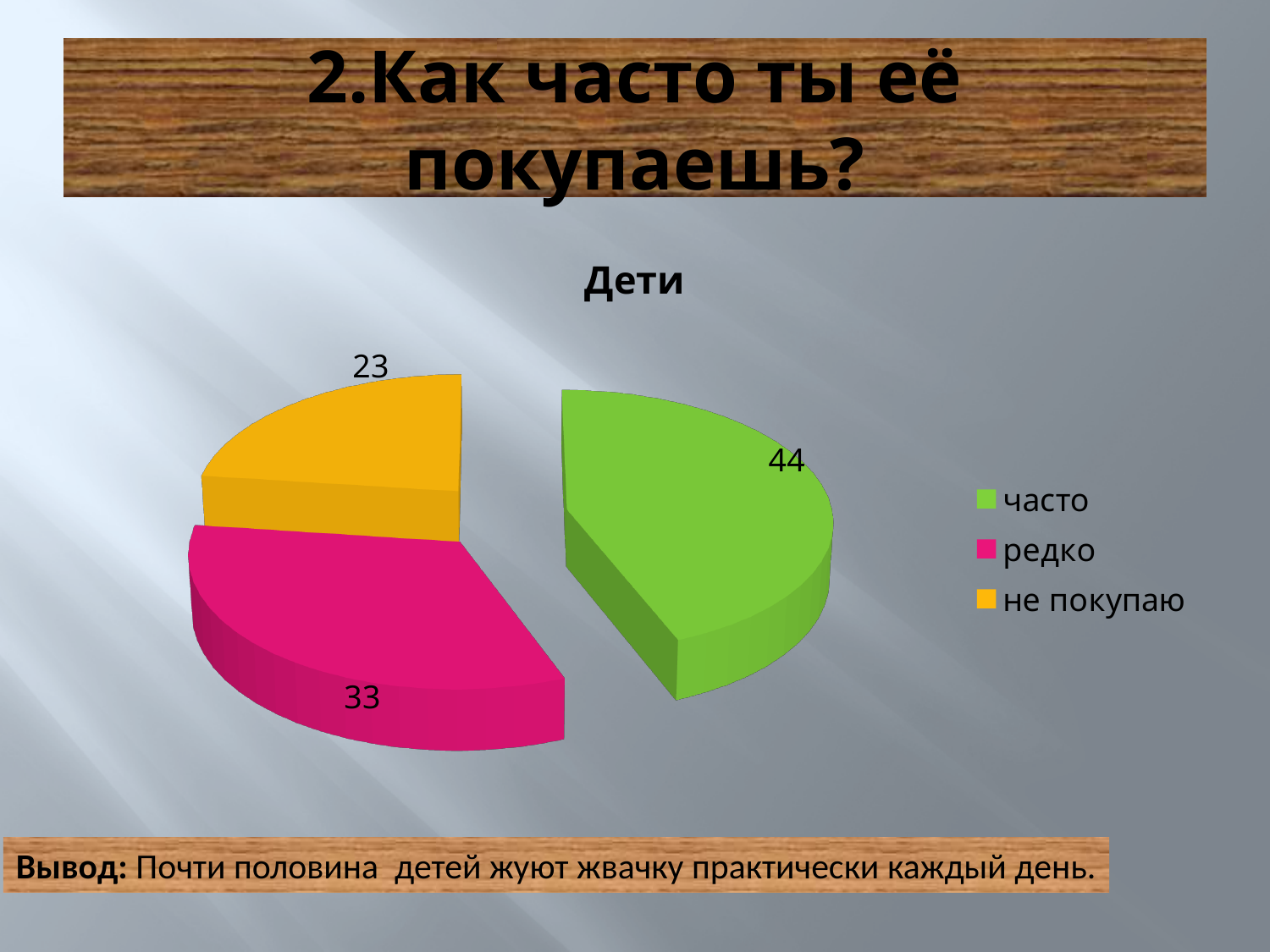
What is the difference between the values for "редко" and "не покупаю"? 10 How many slices does the pie chart have? 3 Which category has the smallest slice? не покупаю What is the value for "часто"? 44 Which category has the largest slice? часто What is the title of the chart? Дети What is the difference between the values for "часто" and "редко"? 11 What share of the pie does "часто" represent? 44% What type of chart is shown on the slide? pie chart What is the value for "редко"? 33 What is the value for "не покупаю"? 23 Which is larger, the value for "редко" or the value for "не покупаю"? редко